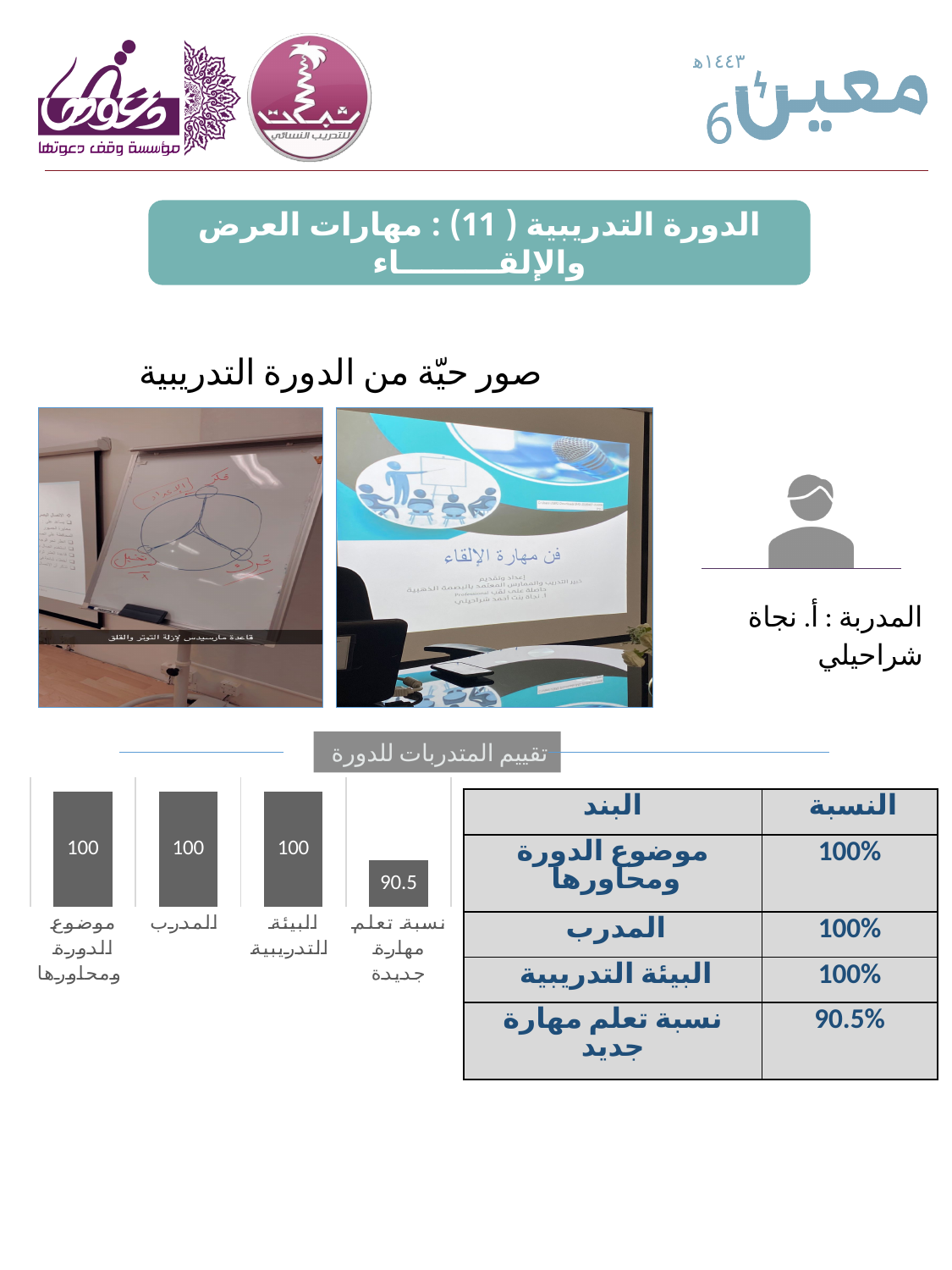
What is the value for "نسبة تعلم مهارة جديدة" in the bar chart? 90.5 How many categories does the bar chart show? 4 What is the title shown above the bar chart? تقييم المتدربات للدورة What is the difference between the value for "المدرب" and the value for "نسبة تعلم مهارة جديدة" in the bar chart? 9.5 What is the value for "المدرب" in the bar chart? 100 What kind of chart is shown under the heading "تقييم المتدربات للدورة"? bar chart What colour are the bars in the bar chart? grey Which is larger in the bar chart: the value for "البيئة التدريبية" or the value for "نسبة تعلم مهارة جديدة"? البيئة التدريبية What is the value for "البيئة التدريبية" in the bar chart? 100 How many categories in the bar chart have a value of 100? 3 Which category has the lowest value in the bar chart? نسبة تعلم مهارة جديدة What is the value for "موضوع الدورة ومحاورها" in the bar chart? 100